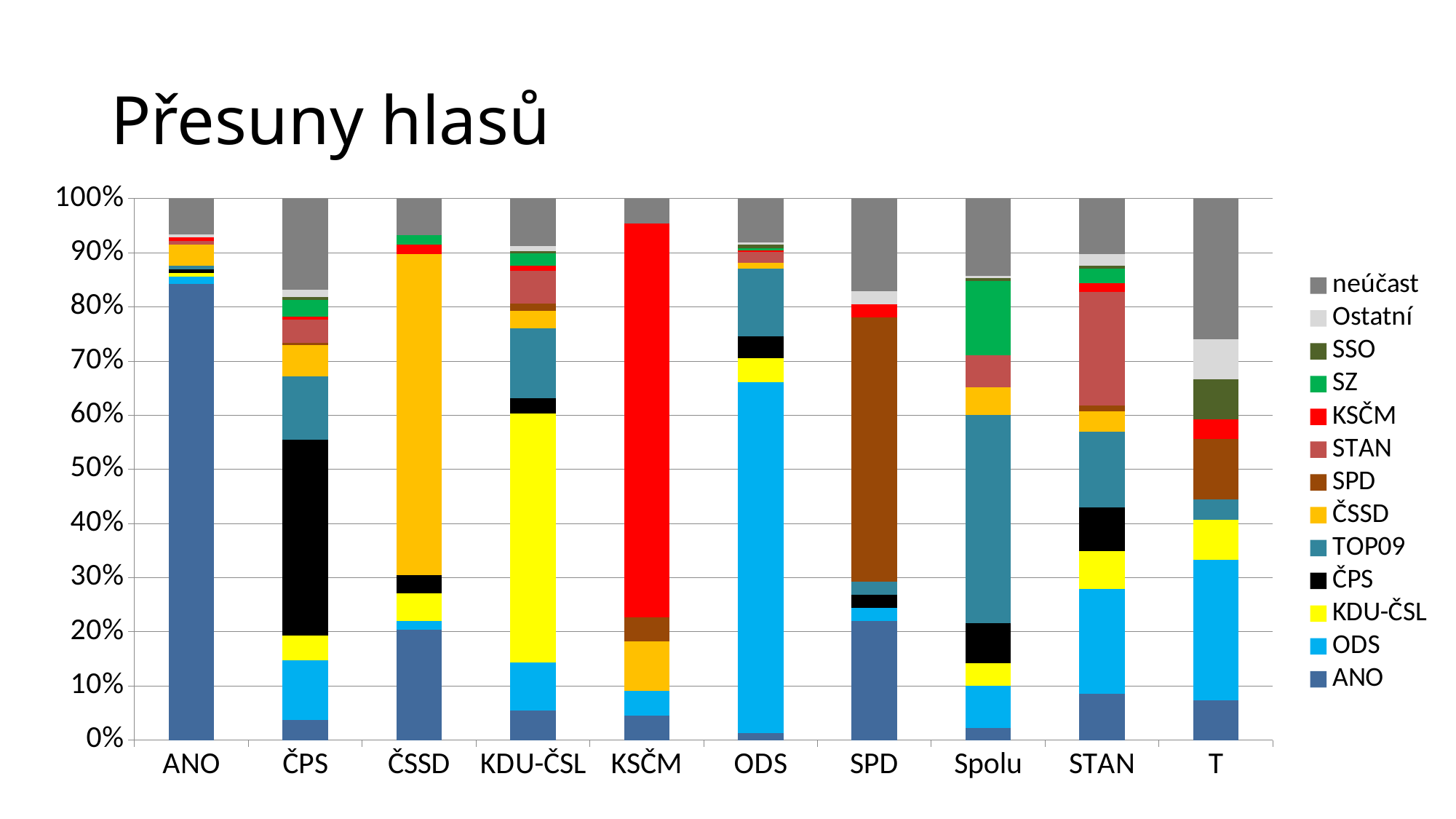
Which category has the largest neúčast segment? T What is the title of the chart? Přesuny hlasů Is the neúčast segment in the T bar greater or less than 20%? greater Which bar has the larger ANO segment, ANO or ČPS? ANO Is the KSČM segment in the KSČM bar greater or less than 70%? greater Is the ANO segment in the ANO bar greater or less than 80%? greater How many series does the legend list? 13 How many categories are shown on the x axis? 10 What kind of chart is shown on the slide? stacked bar chart Which category has the smallest neúčast segment? KSČM What is the total of the ANO stacked bar? 100%